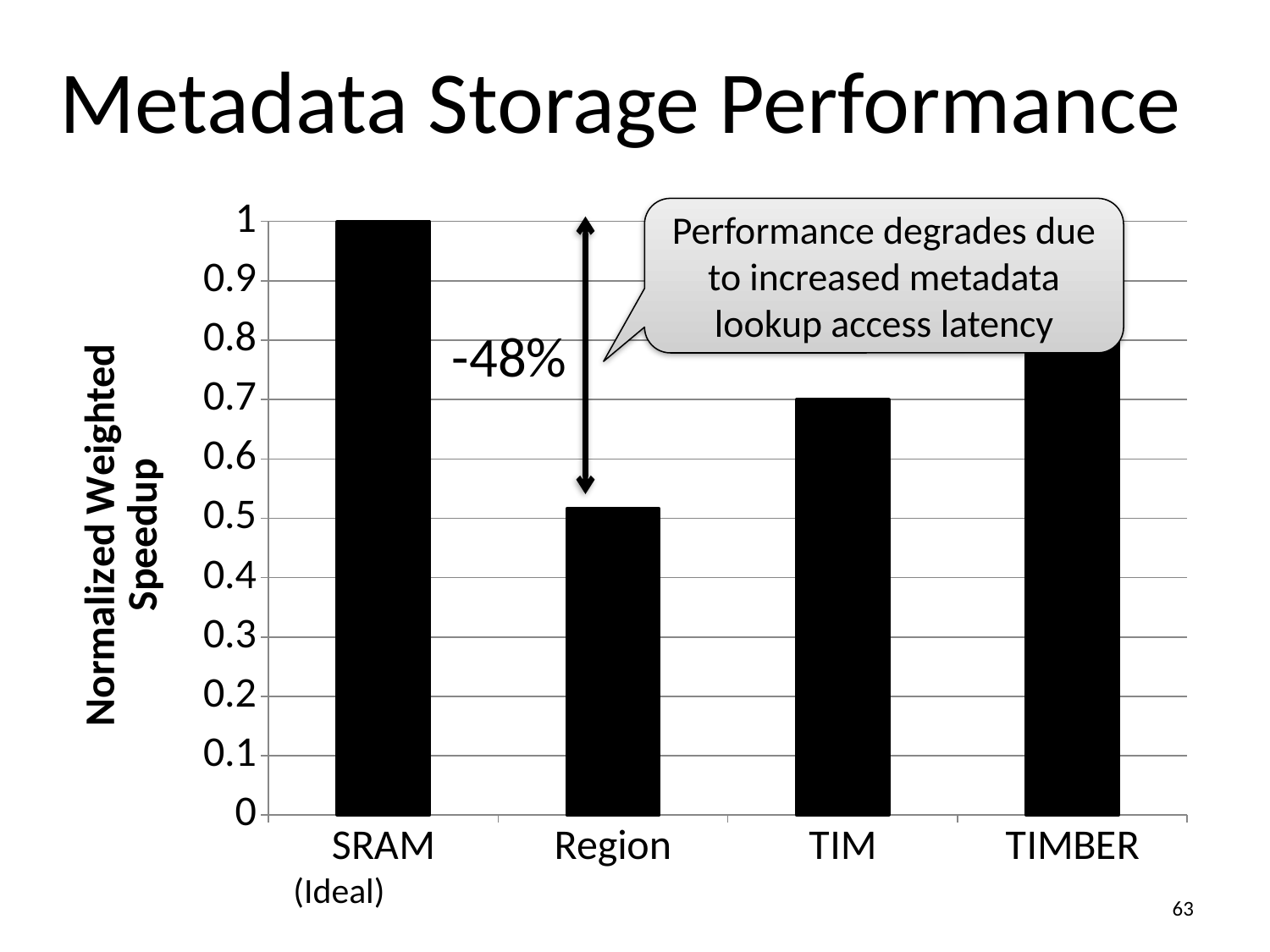
Which category has the lowest normalized weighted speedup? Region Is the value for Region greater or less than 0.5? greater Which category has the highest normalized weighted speedup? SRAM (Ideal) What is the label of the y axis? Normalized Weighted Speedup What kind of chart is shown on the slide? bar chart What is the normalized weighted speedup for SRAM (Ideal)? 1 Which has a higher normalized weighted speedup, TIMBER or TIM? TIMBER What percentage change is annotated next to the arrow between the SRAM and Region bars? -48% Is the value for Region greater or less than 0.6? less Is the value for TIMBER greater or less than 0.7? greater How many categories are plotted on the x axis? 4 Which has a higher normalized weighted speedup, TIM or Region? TIM